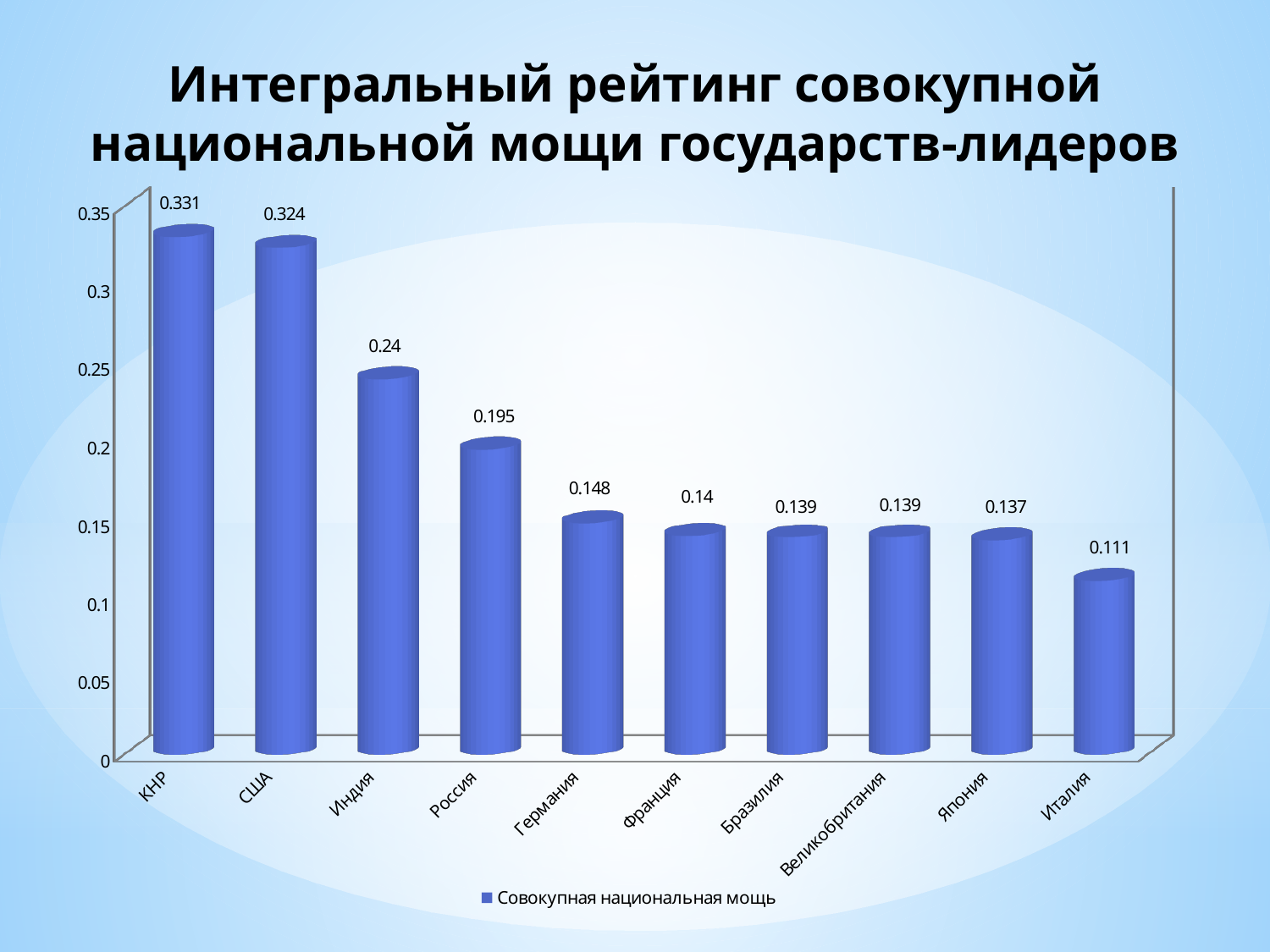
What is the value for КНР? 0.331 How many series does the legend list? 1 What is the value for Италия? 0.111 What kind of chart is shown on the slide? Bar chart What is the legend entry of the chart? Совокупная национальная мощь Which country has the lowest value? Италия How many countries are shown on the chart? 10 What is the difference between the values for КНР and США? 0.007 What is the value for Россия? 0.195 Which country has the highest value? КНР What is the difference between the values for Индия and Россия? 0.045 Which is larger, the value for Индия or the value for Германия? Индия